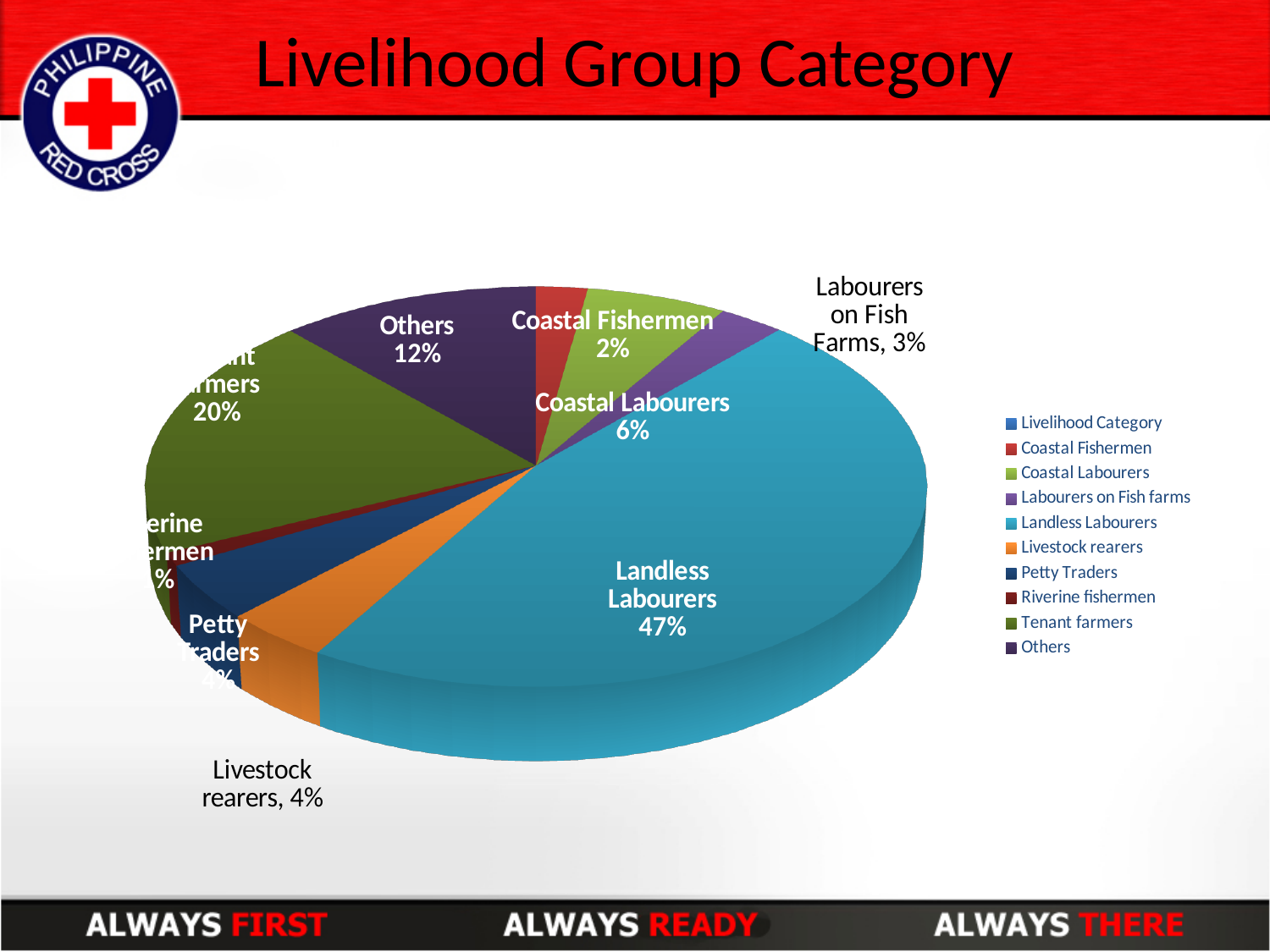
What share does the Others slice represent? 12% What kind of chart is shown on the slide? pie chart How many percentage points larger is the Landless Labourers slice than the Others slice? 35 percentage points What is the value shown for Coastal Fishermen? 2% What is the value shown for Livestock rearers? 4% What is the title of the chart? Livelihood Group Category What is the value shown for Tenant farmers? 20% What is the value shown for Coastal Labourers? 6% Which slice is larger, Coastal Labourers or Labourers on Fish Farms? Coastal Labourers What percentage is labelled for Labourers on Fish Farms? 3% Which livelihood category has the largest slice of the pie? Landless Labourers What percentage of the pie is Landless Labourers? 47%